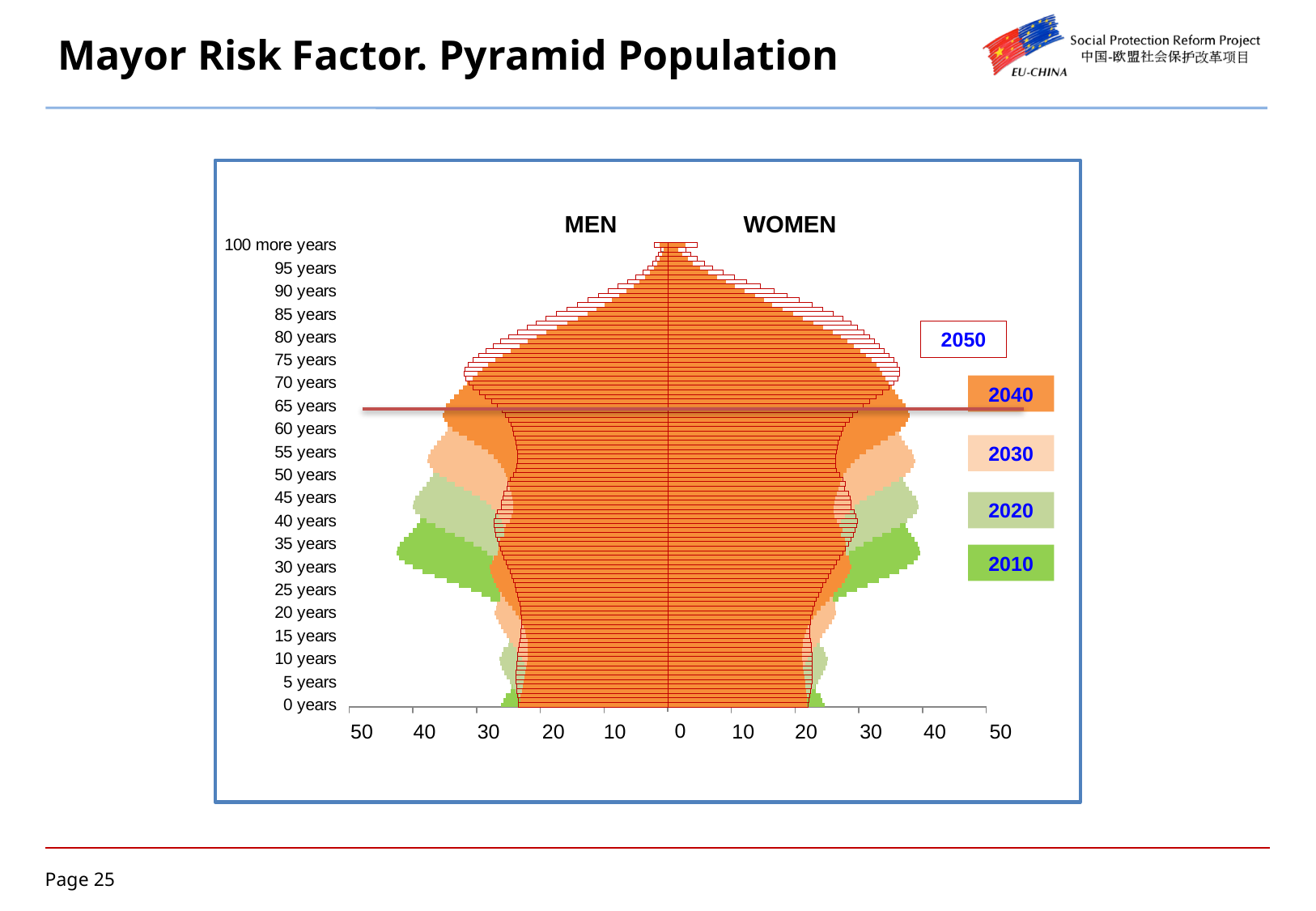
For men in 2010, which is larger: the value at 35 years or the value at 0 years? 35 years Is the value for men aged 95 years in 2050 greater or less than 10? less How many series (years) does the legend list? 5 For the 2050 series, do the values rise or fall from 75 years up to 100 more years? fall Is the value for men aged 0 years in 2010 greater or less than 30? less What kind of chart is shown on the slide? bar chart What are the two sides of the pyramid labelled? MEN and WOMEN How many age groups are shown on the vertical axis? 21 Is the value for women aged 30 years in 2010 greater or less than 30? greater Which years are listed in the legend? 2050, 2040, 2030, 2020, 2010